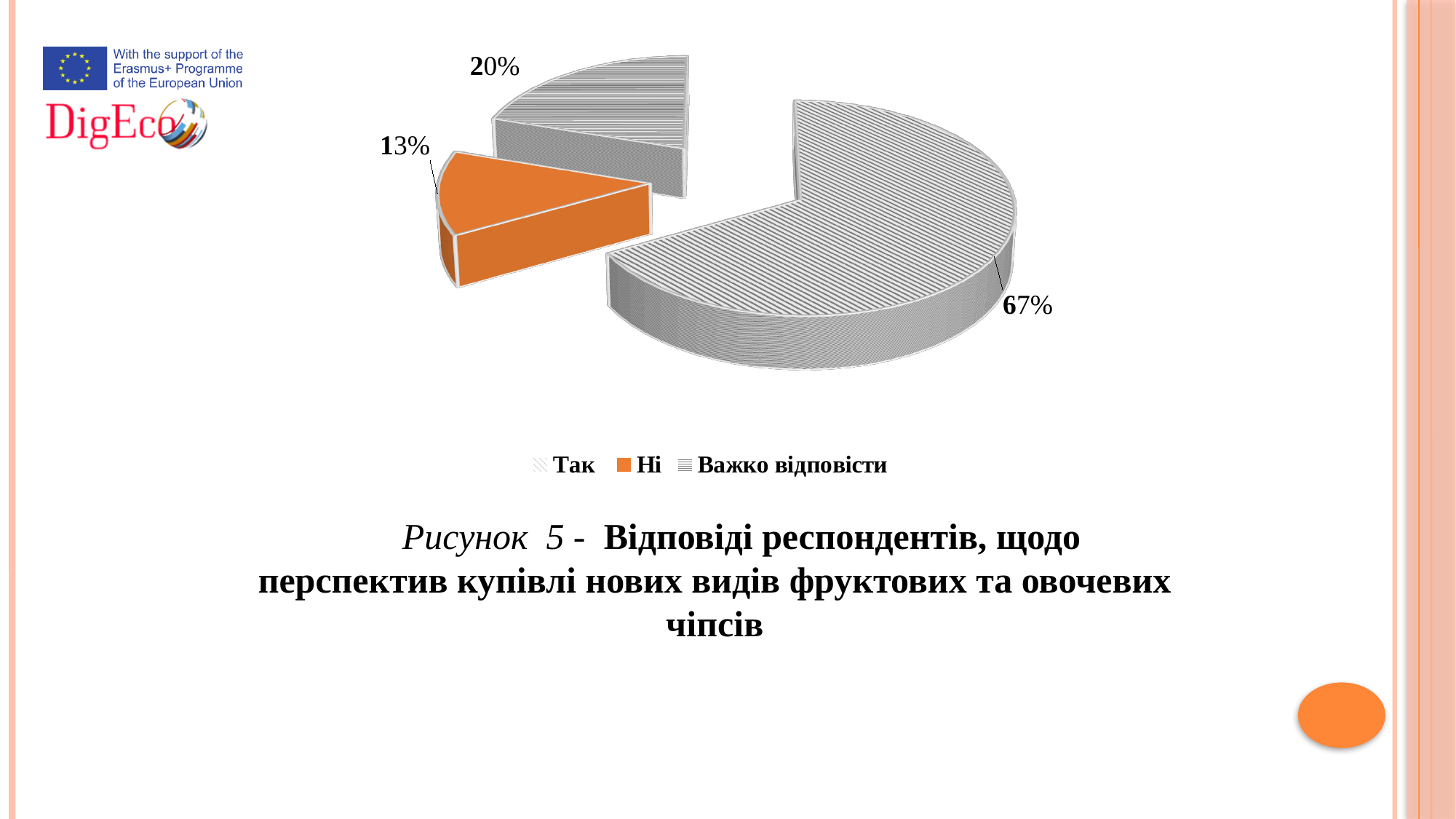
Which answer has the largest share of the pie? Так Which legend entry is shown in orange? Ні Which is larger: the share for "Ні" or the share for "Важко відповісти"? Важко відповісти How many entries does the legend list? 3 What type of chart is shown on the slide? Pie chart How many slices does the pie chart have? 3 What is the difference in percentage points between the "Так" and "Ні" slices? 54 Which answer has the smallest share of the pie? Ні What share of respondents answered "Ні"? 13% What share of respondents answered "Важко відповісти"? 20% What share of respondents answered "Так"? 67% What is the difference in percentage points between the "Важко відповісти" and "Ні" slices? 7